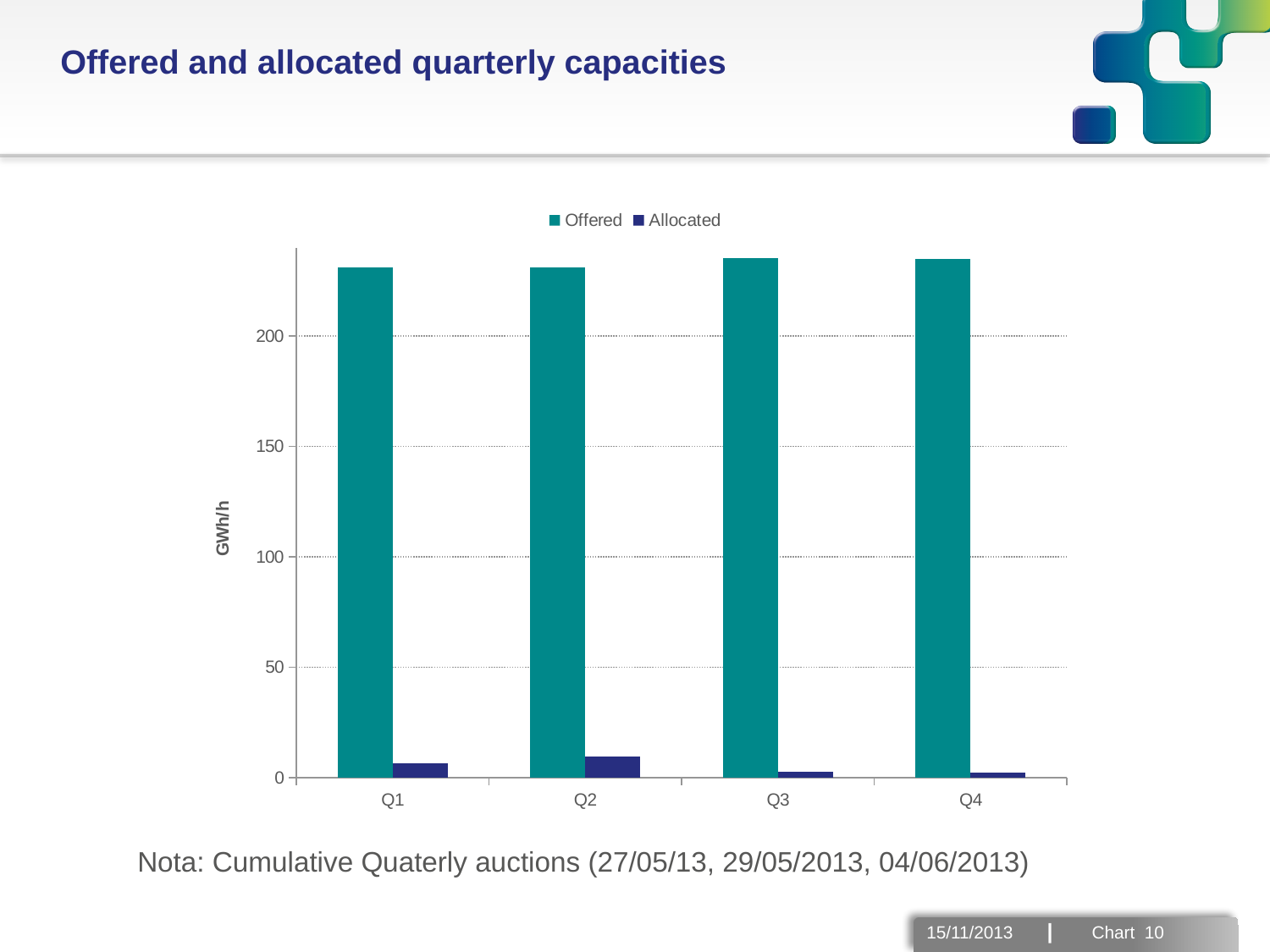
Which is larger, the Allocated value for Q2 or the Allocated value for Q3? Q2 Which series is shown in dark blue? Allocated Which quarter has the highest Allocated value? Q2 How many series does the legend list? 2 What kind of chart is shown on the slide? bar chart Is the Allocated value for Q2 greater or less than 50? less Is the Offered value for Q3 greater or less than 200? greater Which is larger in Q1, the Offered value or the Allocated value? Offered Is the Allocated value for Q4 greater or less than 50? less What is the label on the y axis? GWh/h How many quarters are shown on the x axis? 4